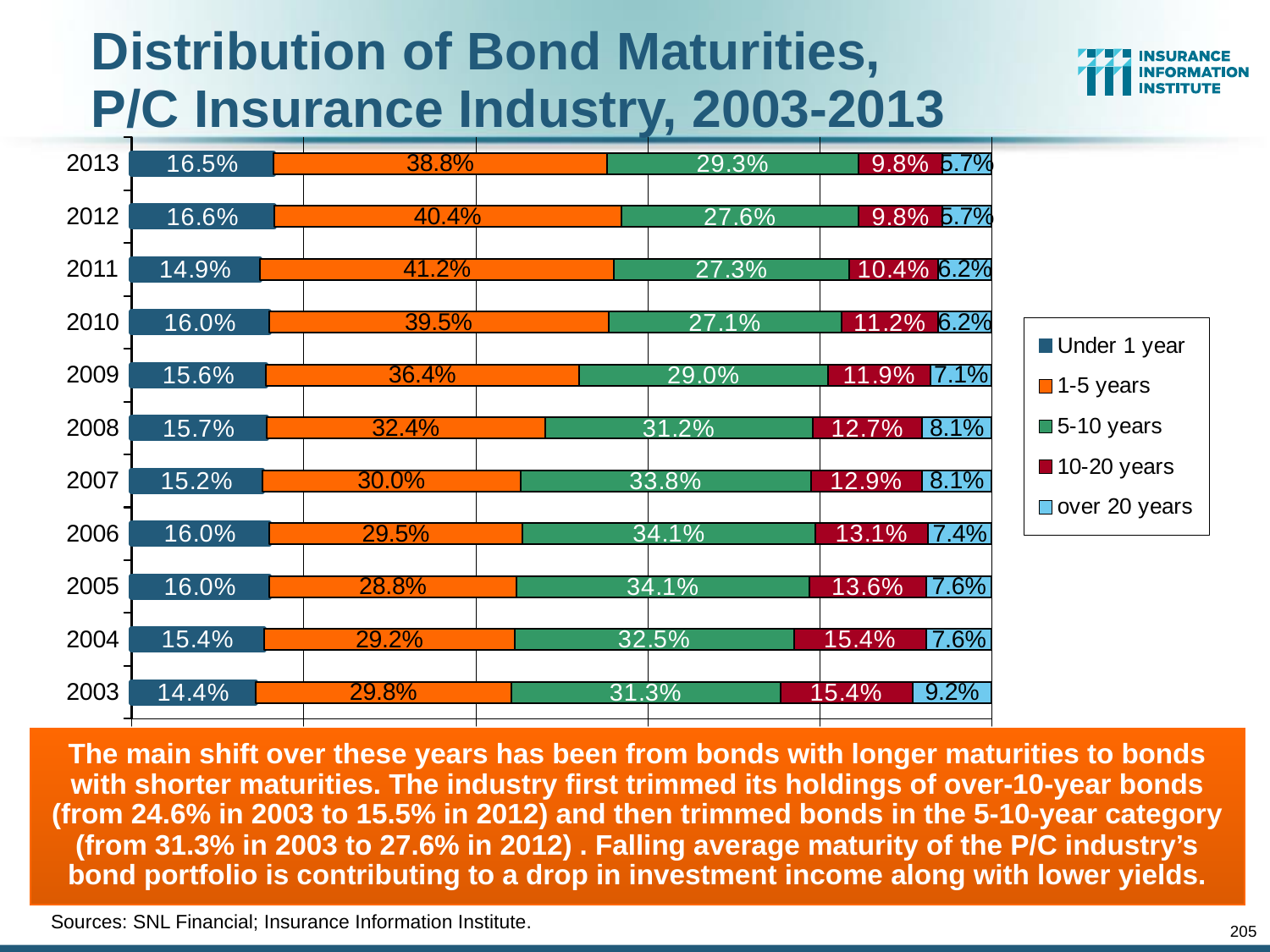
In 2008, which was larger: the 1-5 years share or the 5-10 years share? 1-5 years What share of bonds had 5-10 year maturities in 2006? 34.1% How many years are shown on the chart? 11 What kind of chart is shown on the slide? Bar chart (stacked) What share of bonds had maturities under 1 year in 2003? 14.4% What is the difference between the 10-20 years share in 2003 and in 2013? 5.6 percentage points How many series does the legend list? 5 In which year was the over 20 years share the highest? 2003 What share of bonds had 1-5 year maturities in 2011? 41.2% What is the title of the chart? Distribution of Bond Maturities, P/C Insurance Industry, 2003-2013 In which year was the 1-5 years share the highest? 2011 Does the 1-5 years share rise or fall overall from 2003 to 2013? Rises